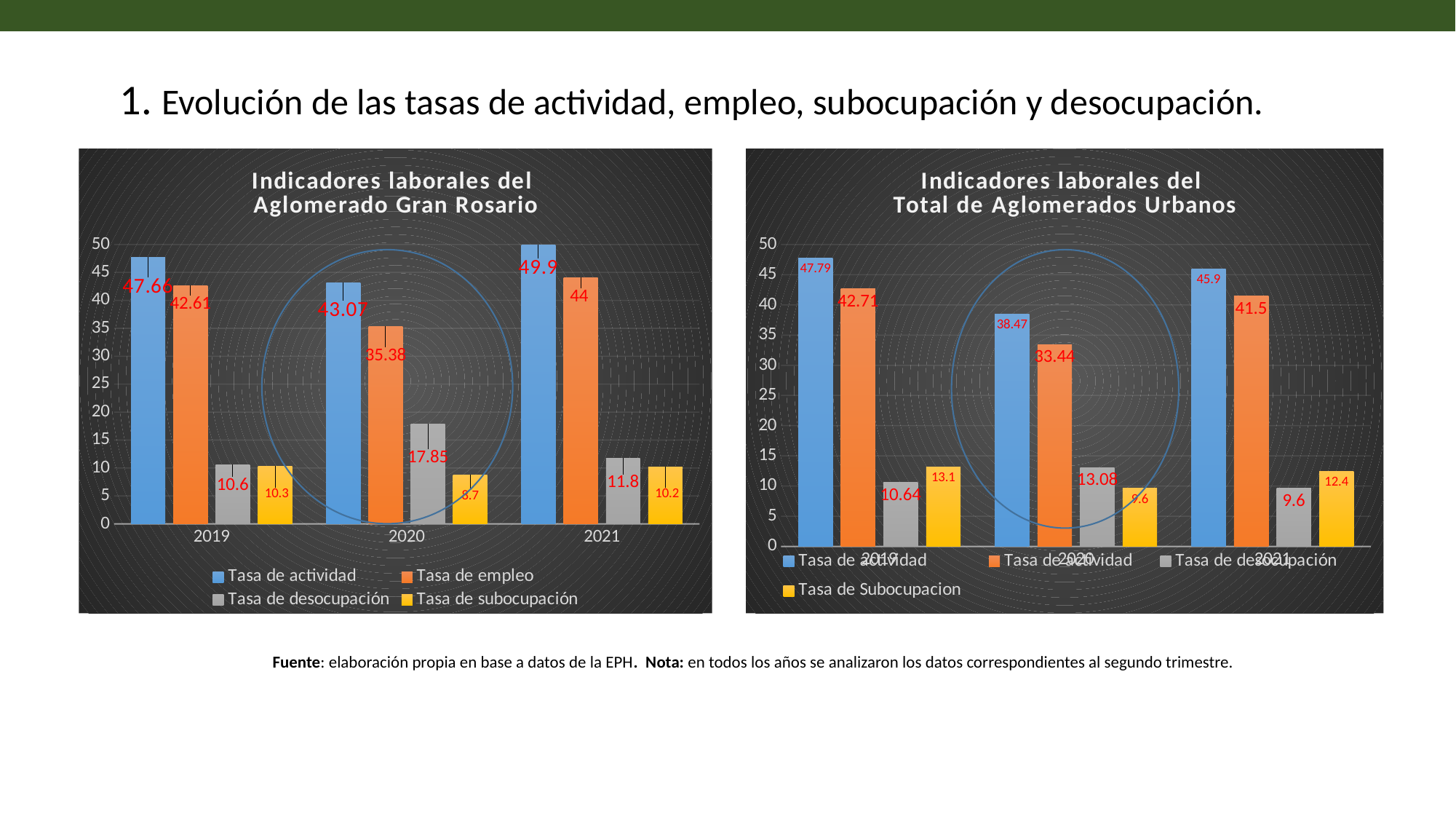
In the chart titled 'Indicadores laborales del Total de Aglomerados Urbanos', is the value of the grey bar (Tasa de desocupación) in 2020 greater or less than 10? greater How many series does the legend of the chart titled 'Indicadores laborales del Aglomerado Gran Rosario' list? 4 In the chart titled 'Indicadores laborales del Total de Aglomerados Urbanos', in which year is the blue bar (Tasa de actividad) highest? 2019 How many years are shown on the x axis of the chart titled 'Indicadores laborales del Aglomerado Gran Rosario'? 3 In the chart titled 'Indicadores laborales del Total de Aglomerados Urbanos', what is the difference between the blue bar (Tasa de actividad) in 2019 and in 2020? 9.32 In the chart titled 'Indicadores laborales del Total de Aglomerados Urbanos', what is the value of the orange bar (Tasa de empleo) in 2020? 33.44 In the chart titled 'Indicadores laborales del Aglomerado Gran Rosario', in which year is Tasa de empleo lowest? 2020 In the chart titled 'Indicadores laborales del Aglomerado Gran Rosario', what is the value of Tasa de actividad in 2021? 49.9 In the chart titled 'Indicadores laborales del Aglomerado Gran Rosario', what is the value of Tasa de desocupación in 2020? 17.85 In the chart titled 'Indicadores laborales del Total de Aglomerados Urbanos', what is the value of the yellow bar (Tasa de Subocupacion) in 2019? 13.1 In the chart titled 'Indicadores laborales del Aglomerado Gran Rosario', which is larger in 2019: Tasa de desocupación or Tasa de subocupación? Tasa de desocupación In the chart titled 'Indicadores laborales del Aglomerado Gran Rosario', what is the difference between Tasa de actividad and Tasa de empleo in 2020? 7.69